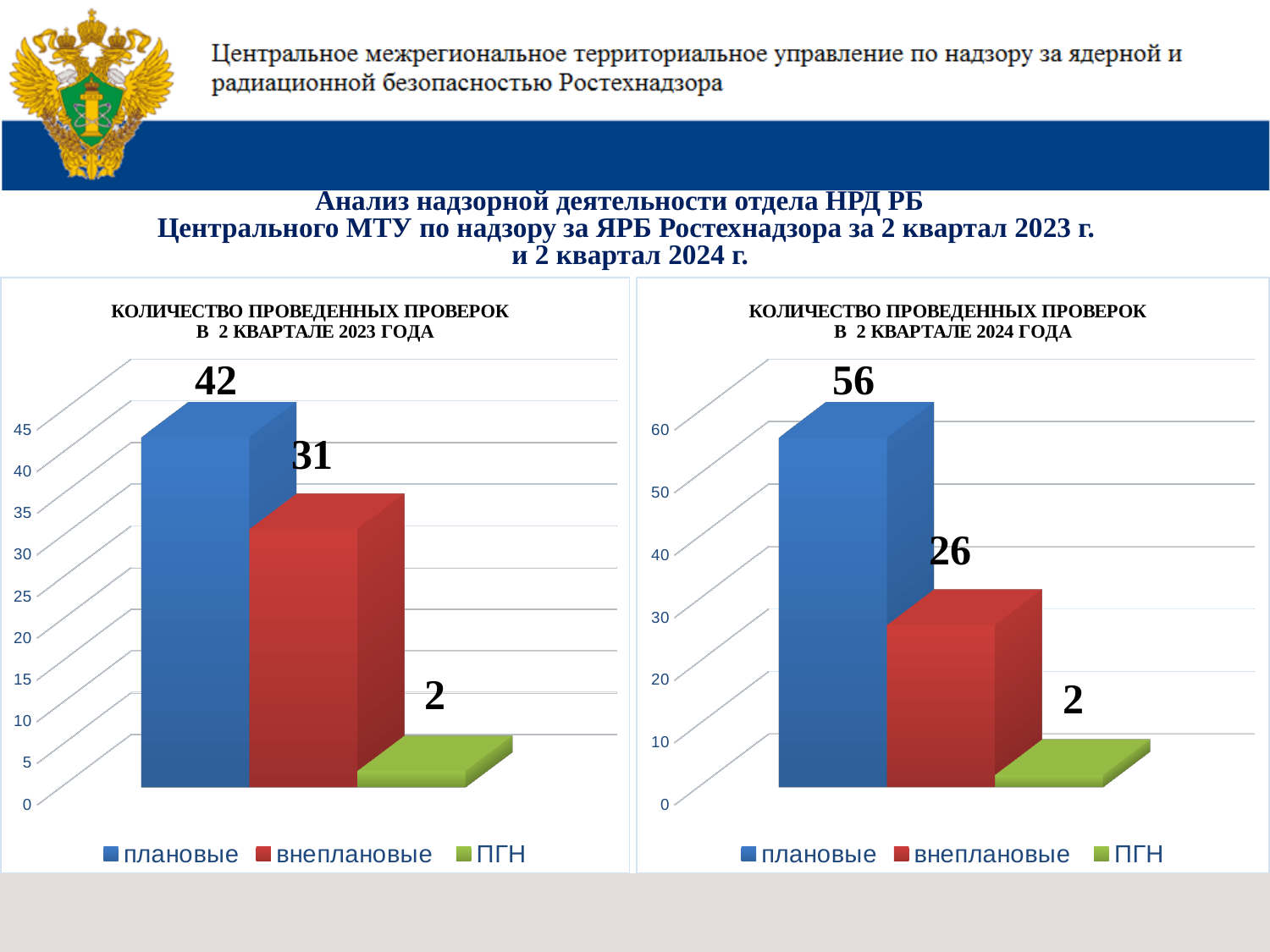
Which is larger: плановые in the left chart (2023) or плановые in the right chart (2024)? плановые in the right chart (2024) In the right chart (2 квартал 2024 года), what is the difference between плановые and внеплановые? 30 In the right chart (2 квартал 2024 года), what is the value for ПГН? 2 In the right chart (2 квартал 2024 года), which series has the lowest value? ПГН What kind of chart is the right chart (2 квартал 2024 года)? bar chart In the left chart (2 квартал 2023 года), what is the value for плановые? 42 In the left chart (2 квартал 2023 года), which series has the highest value? плановые How many series does the legend of the left chart (2 квартал 2023 года) list? 3 In the right chart (2 квартал 2024 года), what is the value for плановые? 56 In the left chart (2 квартал 2023 года), what is the difference between плановые and внеплановые? 11 In the right chart (2 квартал 2024 года), what is the value for внеплановые? 26 In the left chart (2 квартал 2023 года), what is the value for внеплановые? 31